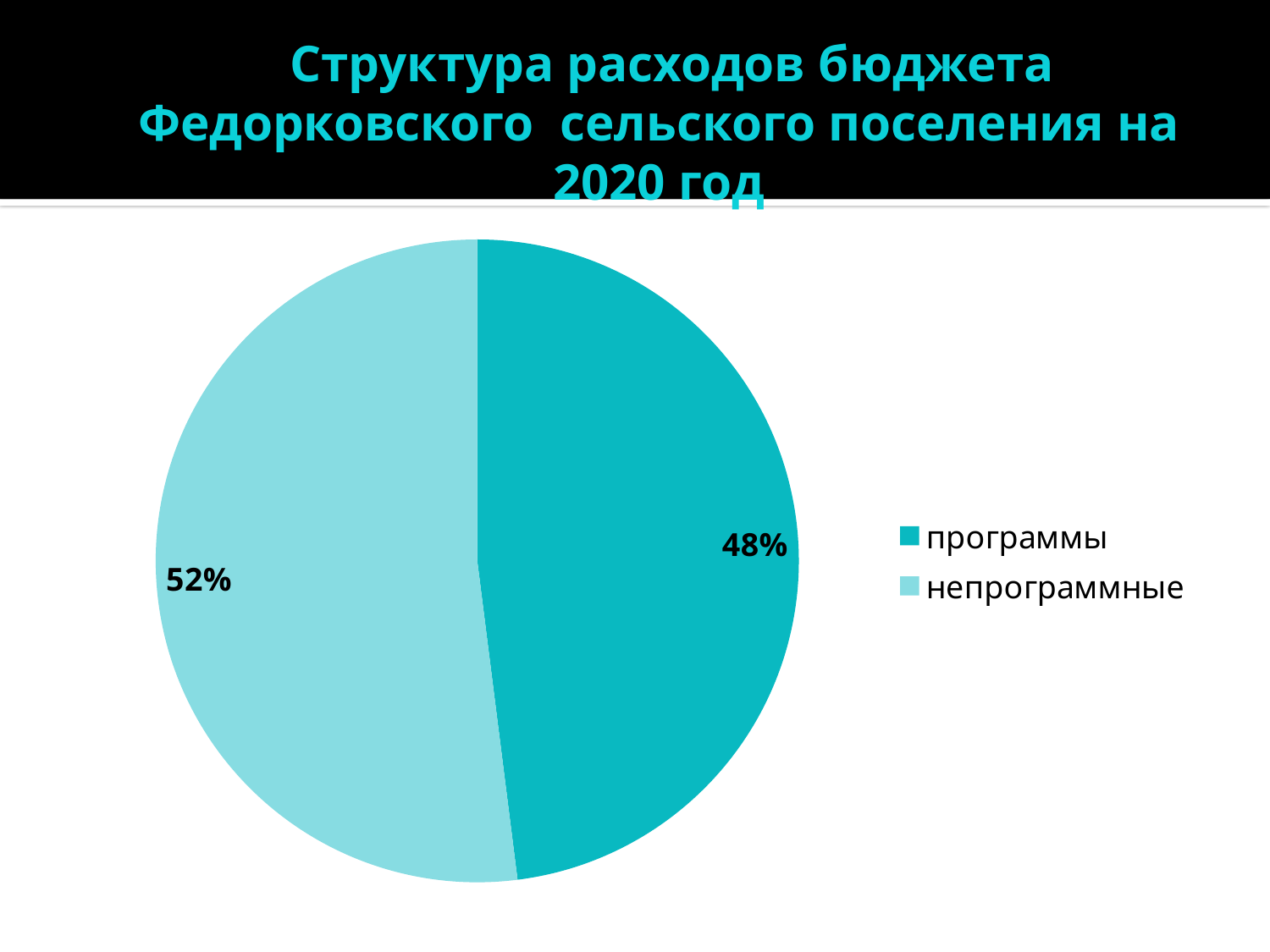
Which slice is the smallest? программы What is the title of the slide containing the chart? Структура расходов бюджета Федорковского сельского поселения на 2020 год Is the share for "программы" greater or less than 50%? less What is the difference between the "непрограммные" and "программы" shares? 4% Which slice is the largest? непрограммные Which legend entry is shown in the lighter shade of blue? непрограммные What kind of chart is shown on the slide? pie chart What share of the pie does the "непрограммные" slice represent? 52% How many slices does the pie chart have? 2 What share of the pie does the "программы" slice represent? 48% How many entries does the legend list? 2 Which is larger, the "программы" slice or the "непрограммные" slice? непрограммные